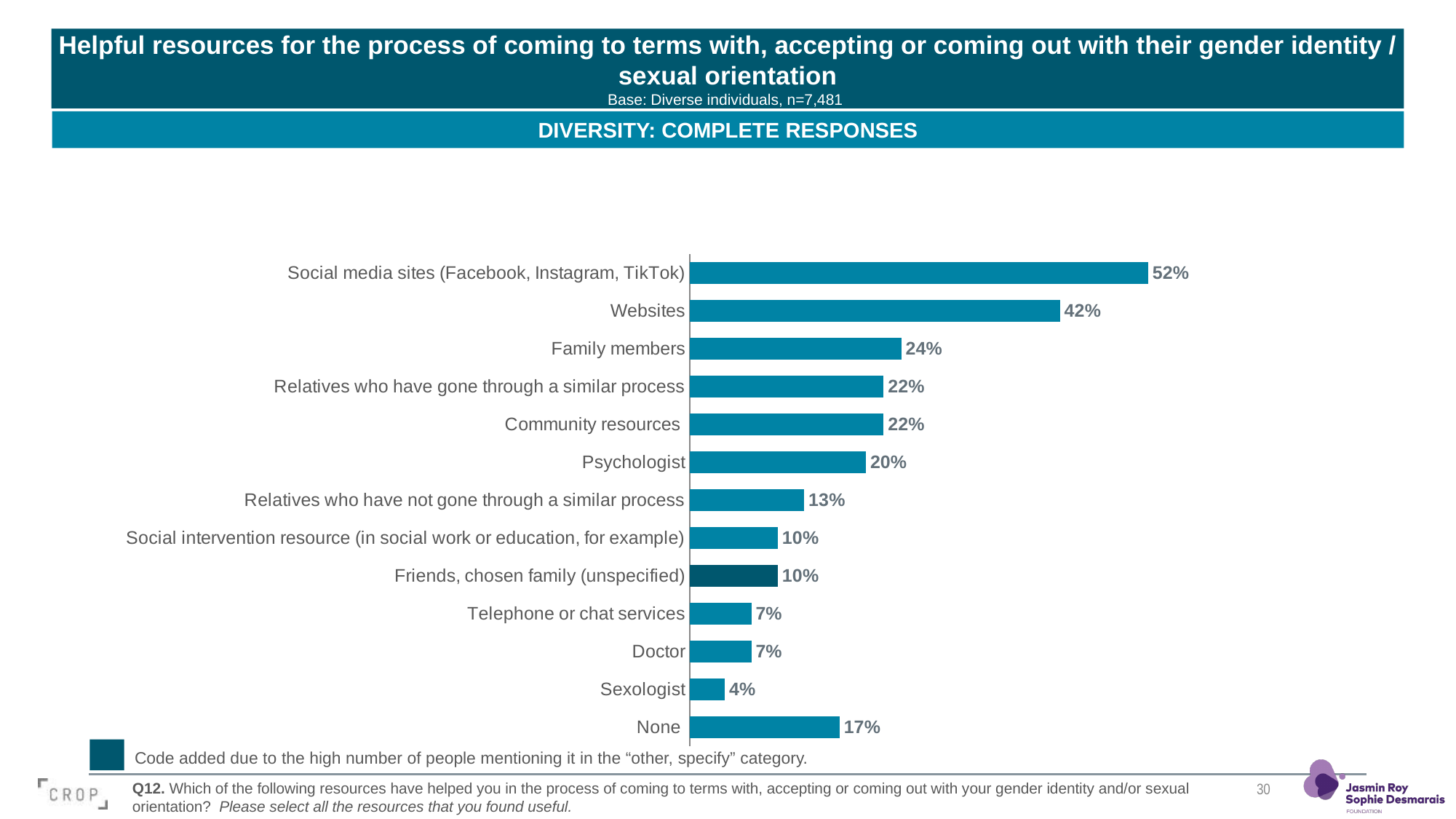
What is the difference between the percentages for Websites and Family members? 18% How many resource categories are shown in the chart? 13 What kind of chart is shown on the slide? Bar chart Which resource has the lowest percentage? Sexologist Which is larger: the value for Relatives who have not gone through a similar process or the value for Doctor? Relatives who have not gone through a similar process What is the value shown for Psychologist? 20% Which resource has the highest percentage? Social media sites (Facebook, Instagram, TikTok) What percentage of respondents selected None? 17% Which category is shown with a darker bar colour than the others? Friends, chosen family (unspecified) What percentage of respondents found social media sites (Facebook, Instagram, TikTok) helpful? 52% What is the difference between the values for Social media sites and Sexologist? 48% What is the base size (n) stated under the chart title? n=7,481